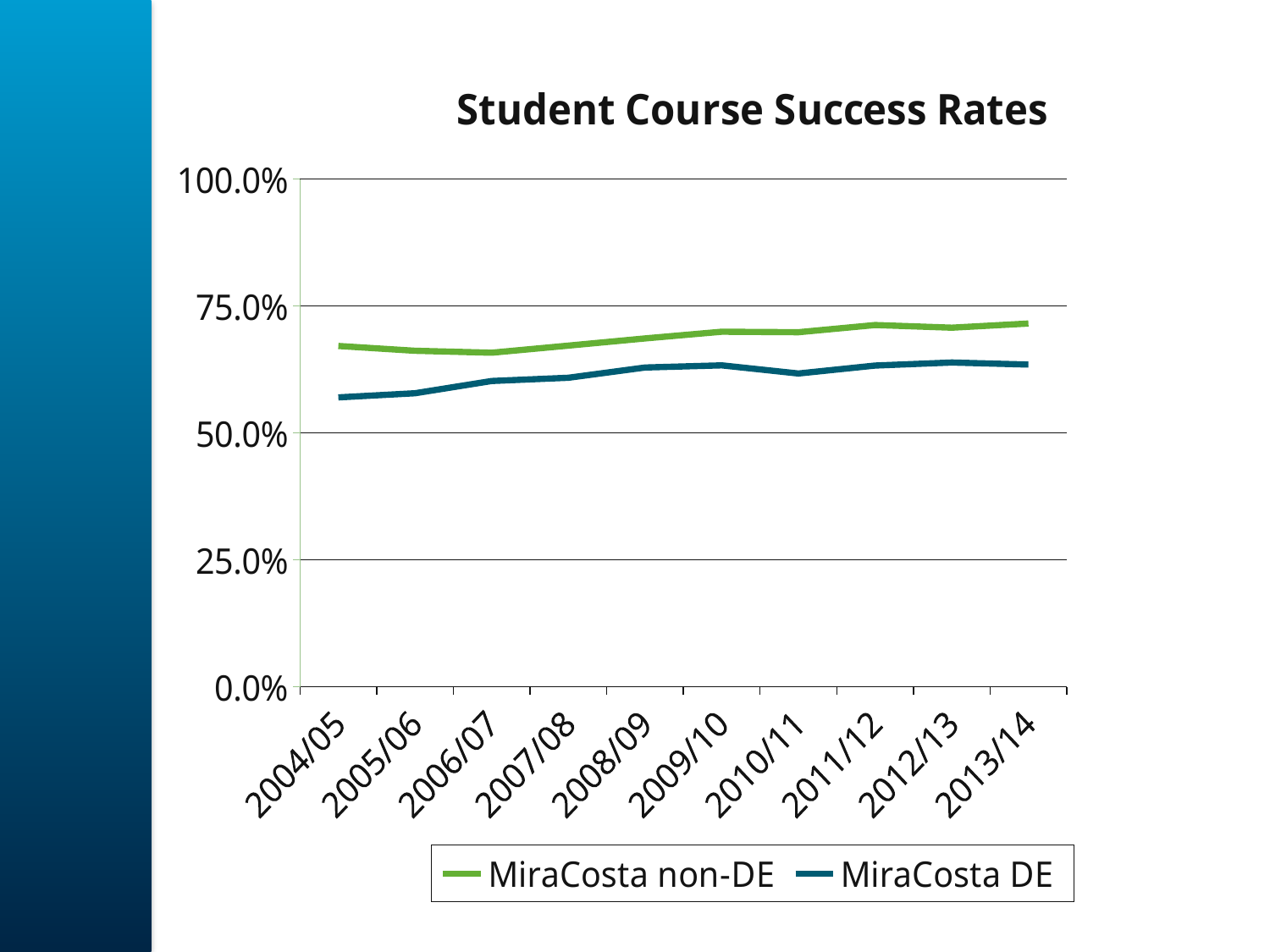
What kind of chart is shown on the slide? line chart How many academic years are shown on the x axis? 10 Is the value for MiraCosta DE in 2013/14 greater or less than 75.0%? less Which series has the higher value in 2004/05, MiraCosta non-DE or MiraCosta DE? MiraCosta non-DE Does the MiraCosta DE line generally rise or fall from 2004/05 to 2013/14? rise Which series is plotted with the green line? MiraCosta non-DE Is the value for MiraCosta DE in 2004/05 greater or less than 50.0%? greater How many series does the legend list? 2 What is the title of the chart? Student Course Success Rates Is the value for MiraCosta non-DE in 2013/14 greater or less than 75.0%? less Which series has the higher value in 2013/14, MiraCosta non-DE or MiraCosta DE? MiraCosta non-DE Does the MiraCosta non-DE line generally rise or fall from 2004/05 to 2013/14? rise